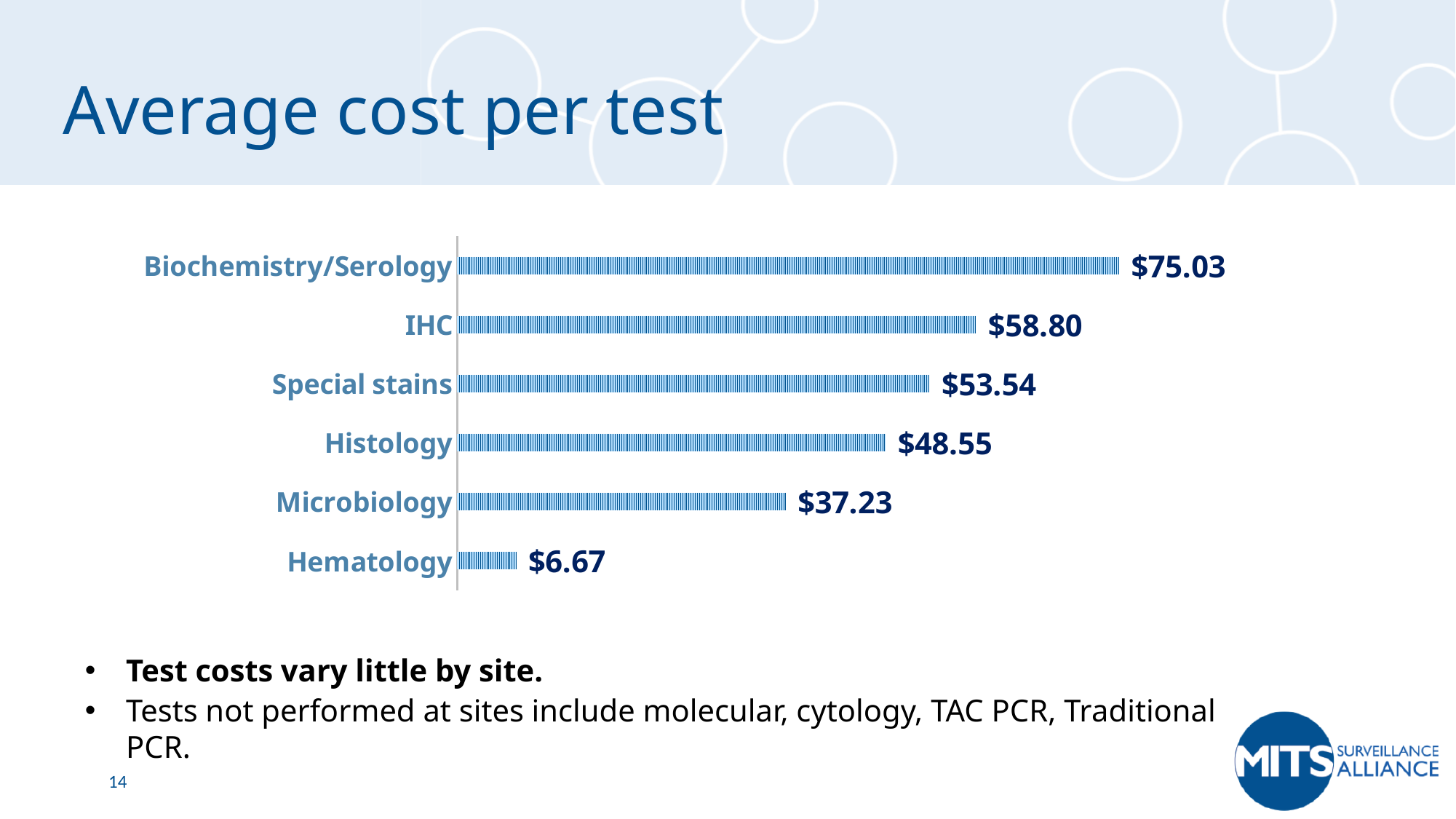
What is the average cost per test for Microbiology? $37.23 What is the title of the slide containing the chart? Average cost per test Which test category has the highest average cost per test? Biochemistry/Serology What is the difference in average cost per test between Biochemistry/Serology and Microbiology? $37.80 What is the average cost per test for Histology? $48.55 Which has a higher average cost per test, Histology or Microbiology? Histology What is the difference in average cost per test between IHC and Special stains? $5.26 What kind of chart is shown on the slide? Bar chart Which test category has the lowest average cost per test? Hematology What is the average cost per test for Biochemistry/Serology? $75.03 How many test categories are shown in the chart? 6 What is the average cost per test for Hematology? $6.67